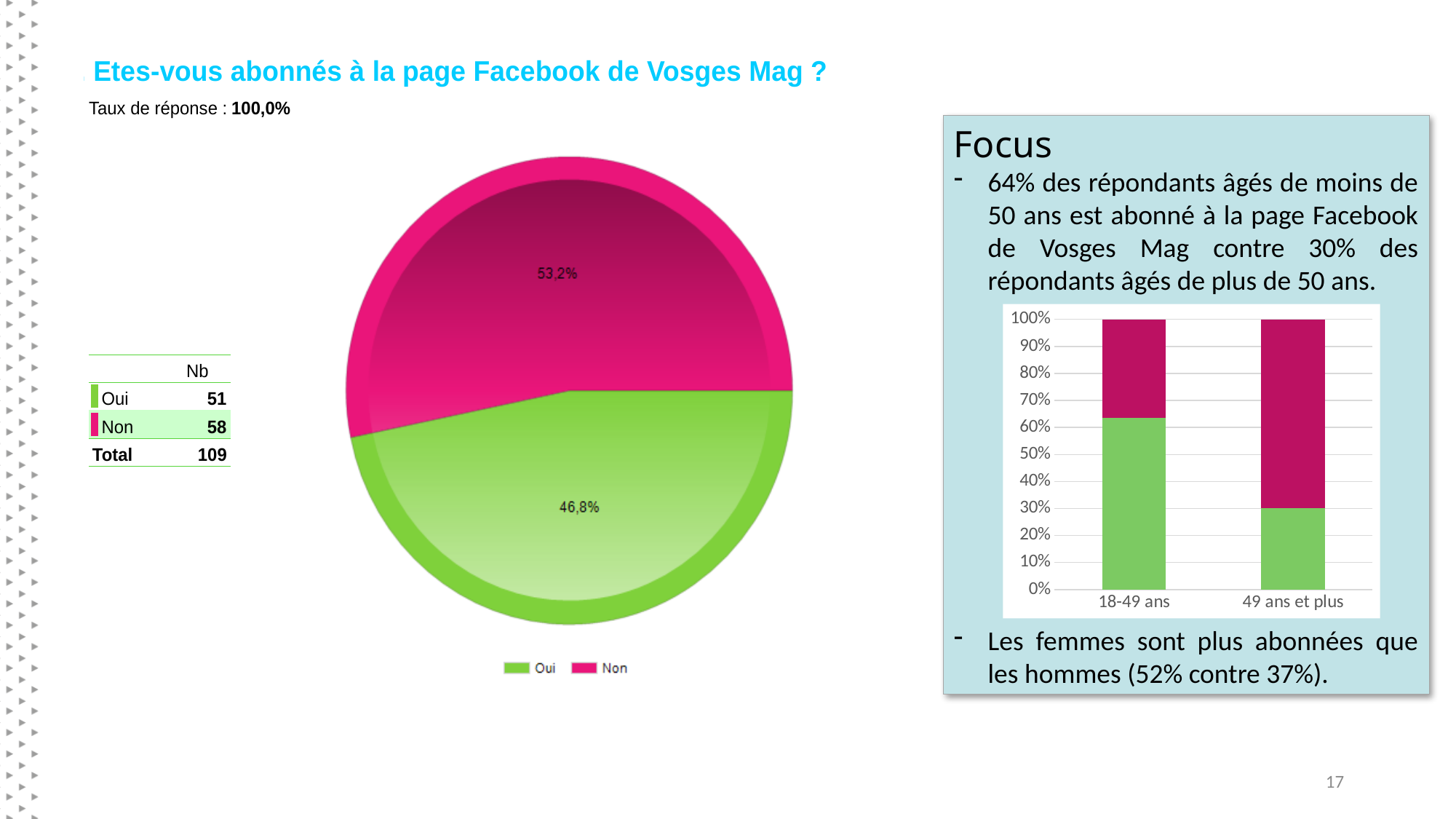
In the pie chart, what is the difference in percentage points between the Non slice and the Oui slice? 6,4 How many entries does the legend of the pie chart list? 2 In the pie chart, what percentage is shown for the Non slice? 53,2% In the stacked bar chart in the Focus box, is the green portion for 18-49 ans greater or less than 50%? greater In the pie chart, which slice is larger, Oui or Non? Non In the pie chart, what percentage is shown for the Oui slice? 46,8% In the stacked bar chart in the Focus box, how many categories are shown on the x axis? 2 In the stacked bar chart in the Focus box, which category has the larger green portion, 18-49 ans or 49 ans et plus? 18-49 ans In the pie chart, which colour represents Oui? Green What kind of chart is shown inside the Focus box on the right? Stacked bar chart How many slices does the pie chart have? 2 What kind of chart is the large chart in the centre of the slide? Pie chart